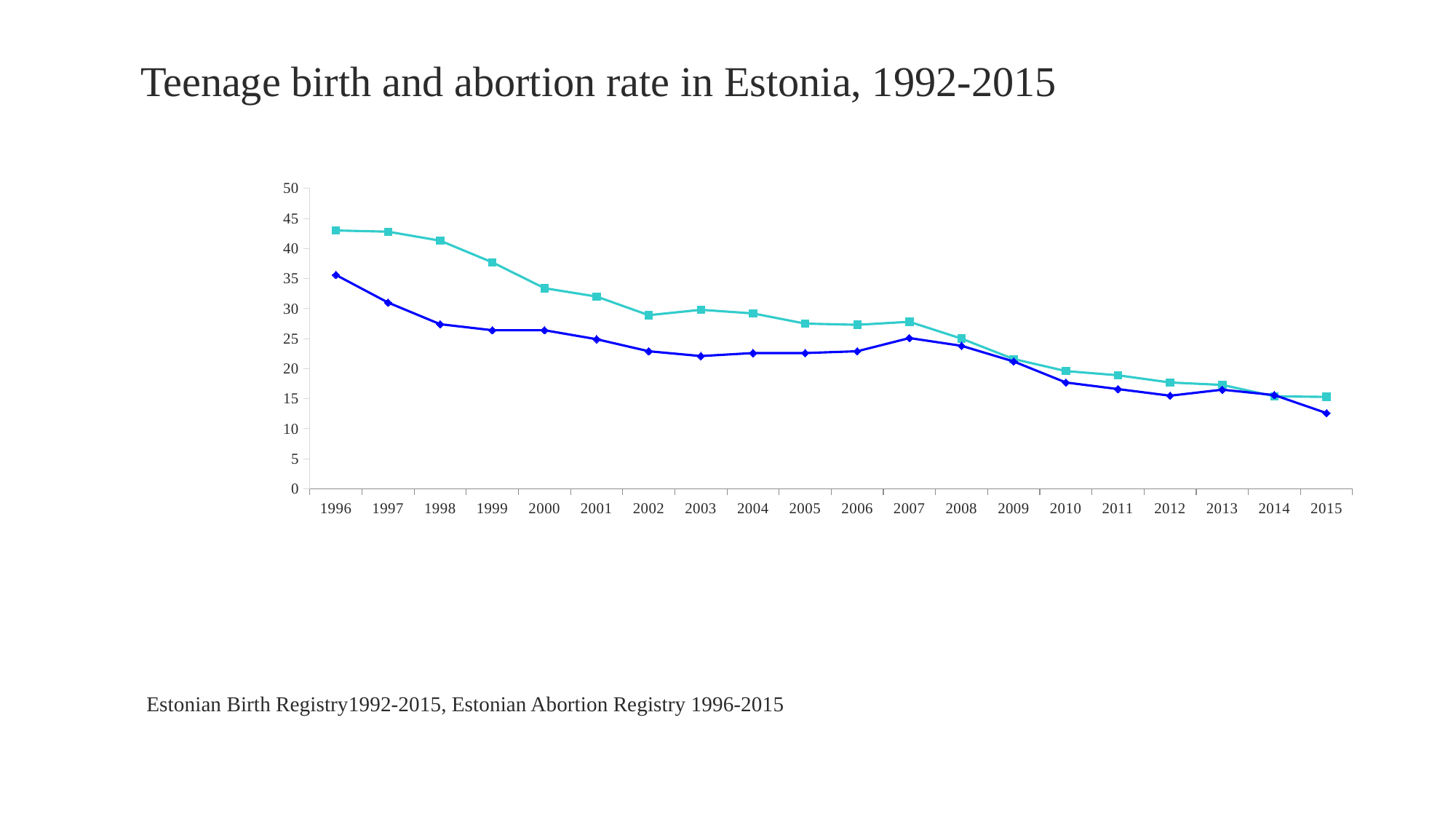
Do the values of the dark blue diamond-marker line generally rise or fall from 1996 to 2015? fall Do the values of the light blue square-marker line generally rise or fall from 1996 to 2015? fall What kind of chart is shown on the slide? line chart In which year is the dark blue diamond-marker line at its highest? 1996 Is the value of the dark blue diamond-marker line in 2015 greater or less than 15? less What is the title of the slide containing the chart? Teenage birth and abortion rate in Estonia, 1992-2015 In which year is the dark blue diamond-marker line at its lowest? 2015 In 1999, which line has the higher value: the light blue square-marker line or the dark blue diamond-marker line? the light blue square-marker line What is the highest value shown on the y axis of the chart? 50 How many years are shown along the x axis of the chart? 20 Is the value of the dark blue diamond-marker line in 2003 greater or less than 25? less Is the value of the light blue square-marker line in 1996 greater or less than 40? greater